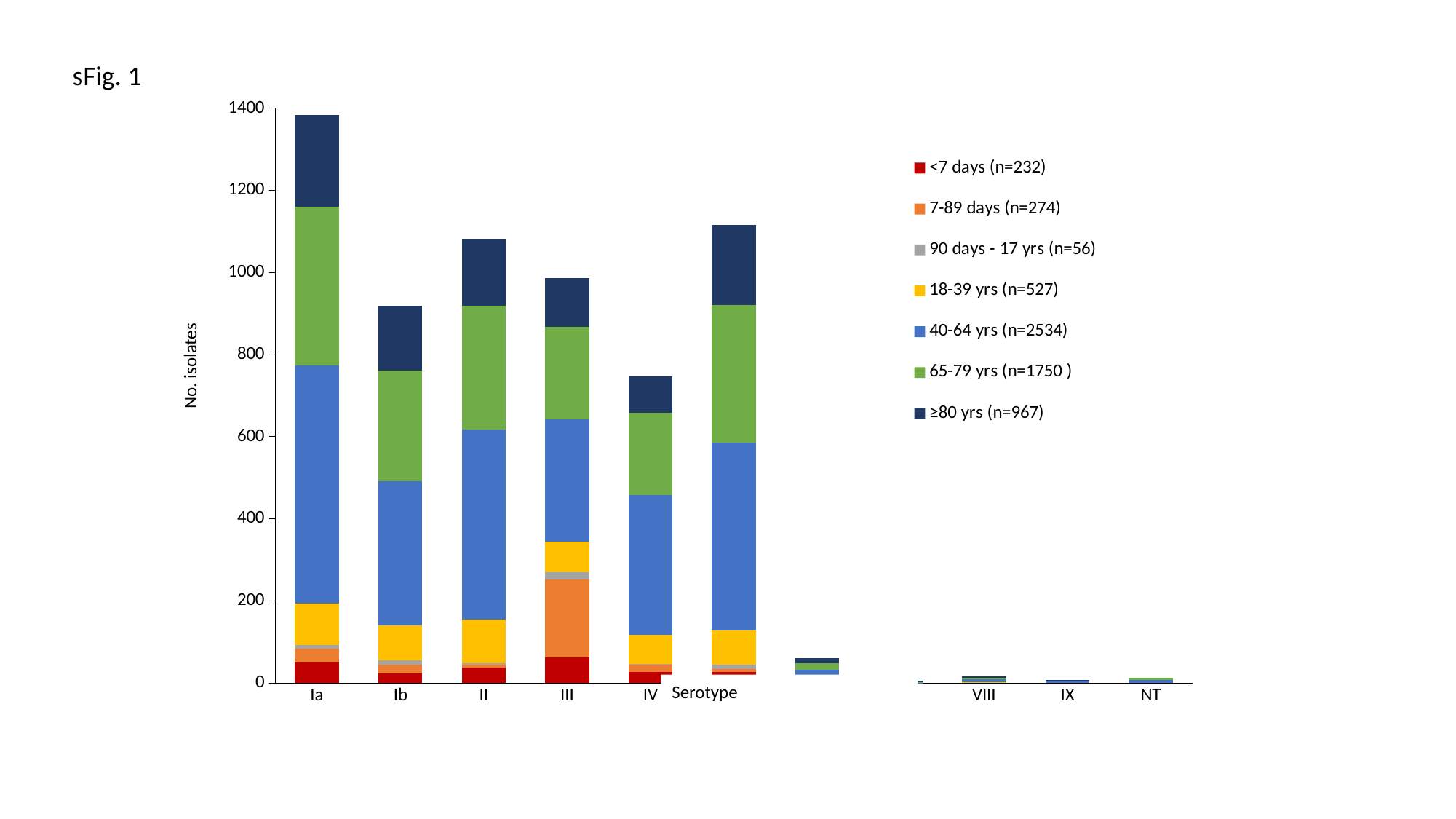
Which has more isolates in total, serotype Ia or serotype Ib? Ia Is the total number of isolates for serotype VIII greater or less than 200? less Is the total number of isolates for serotype Ia greater or less than 1200? greater Is the total number of isolates for serotype II greater or less than 1000? greater How many series does the legend list? 7 Which has more isolates in total, serotype III or serotype IV? III What kind of chart is shown on the slide? Stacked bar chart What is the label of the y axis? No. isolates According to the legend, what is the n for the 40-64 yrs age group? 2534 Which serotype has the highest total number of isolates? Ia